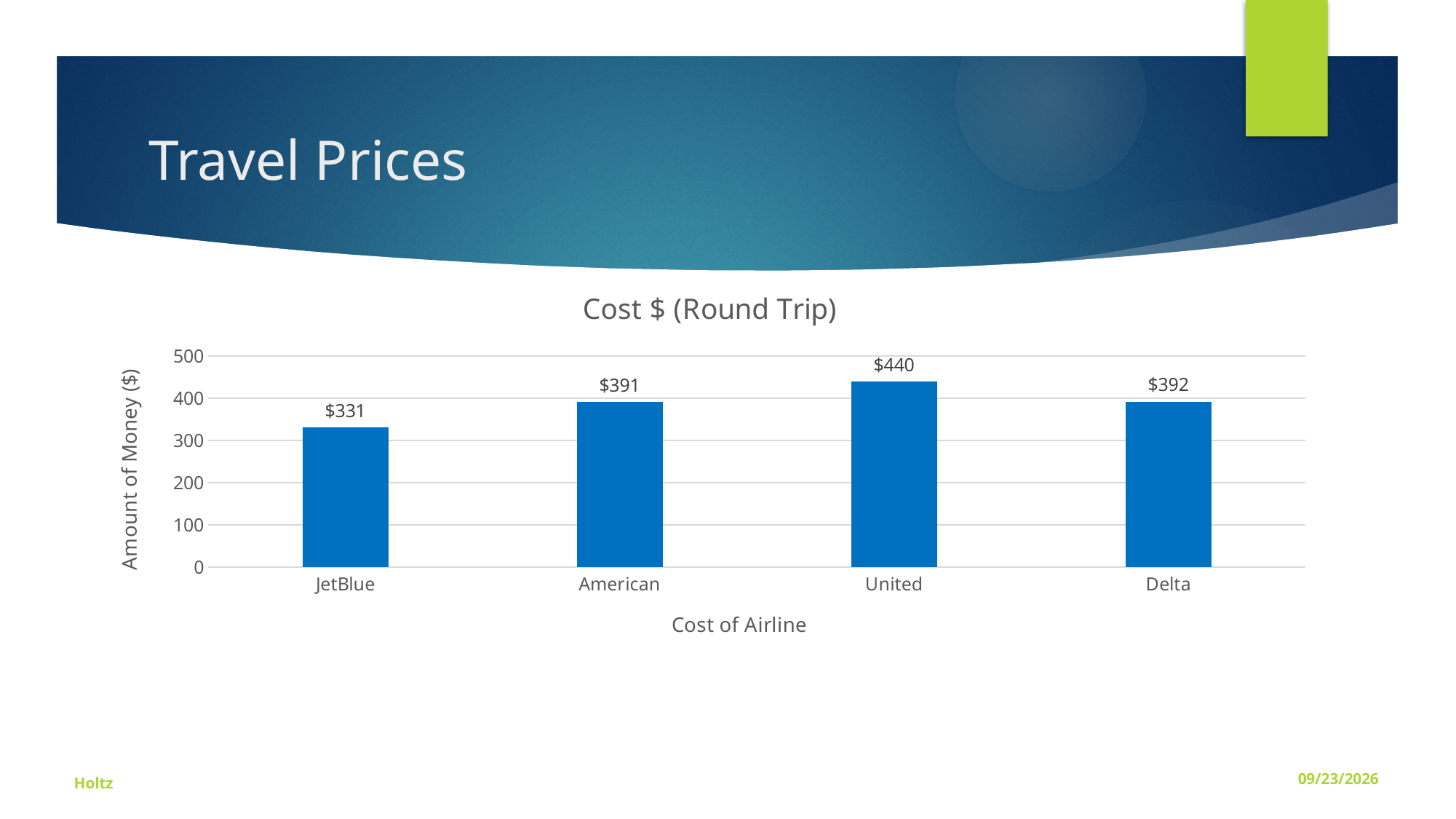
Which airline has the highest round trip cost? United Which airline has the lowest round trip cost? JetBlue Which is more expensive, United or American? United What is the round trip cost for JetBlue? $331 What is the round trip cost for Delta? $392 How many airlines are shown in the chart? 4 What is the difference in cost between United and JetBlue? $109 What is the difference in cost between Delta and American? $1 What type of chart is shown on the slide? Bar chart Is the value for JetBlue greater or less than 400? less What is the round trip cost for United? $440 What is the title of the chart? Cost $ (Round Trip)